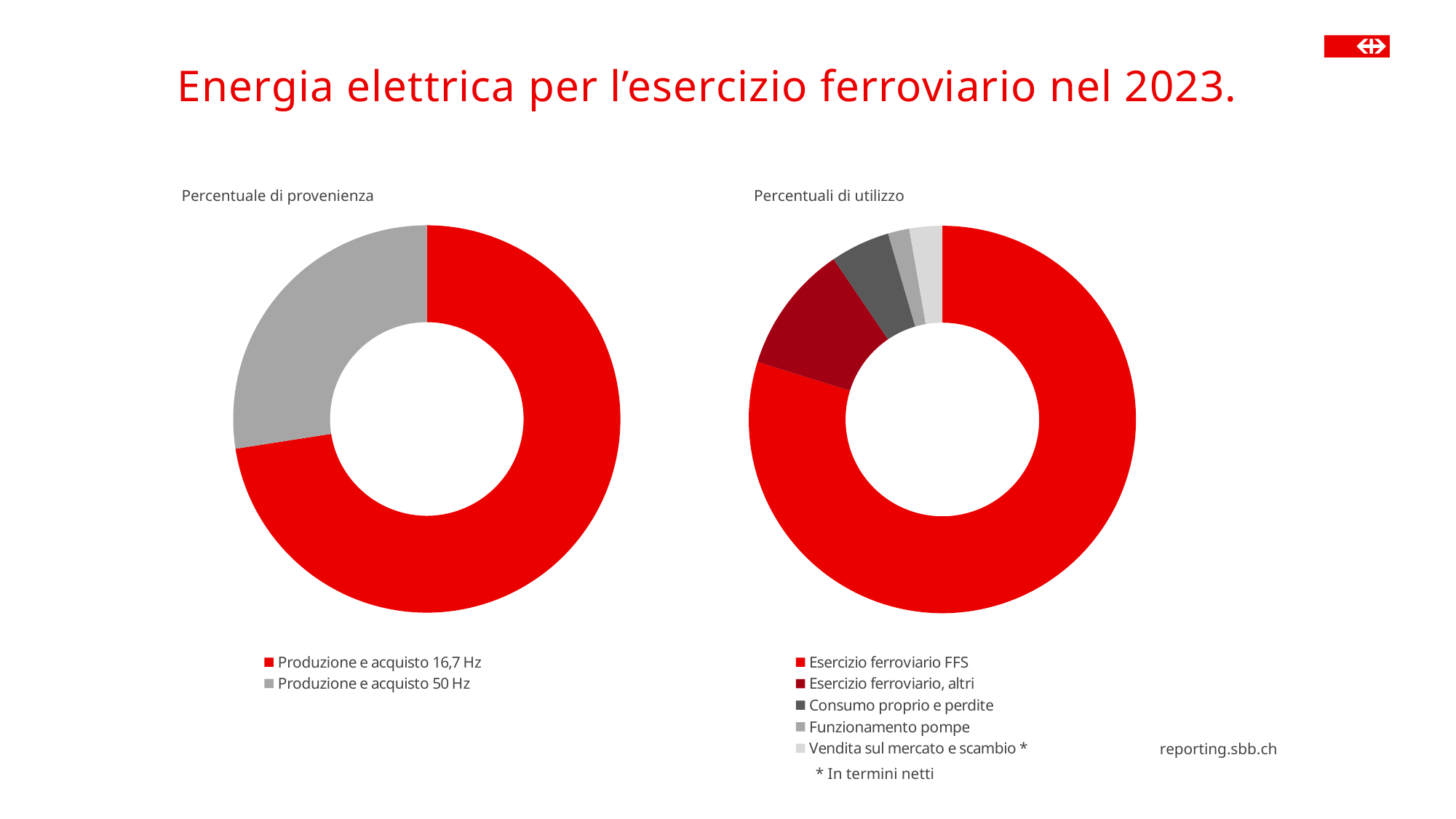
In the 'Percentuali di utilizzo' chart, which is larger: 'Esercizio ferroviario, altri' or 'Consumo proprio e perdite'? Esercizio ferroviario, altri How many entries does the legend of the 'Percentuale di provenienza' chart list? 2 What is the title of the slide? Energia elettrica per l'esercizio ferroviario nel 2023. In the 'Percentuale di provenienza' chart, what colour is the slice for 'Produzione e acquisto 50 Hz'? Grey In the 'Percentuali di utilizzo' chart, which category has the largest share? Esercizio ferroviario FFS In the 'Percentuale di provenienza' chart, how many slices are there? 2 What kind of chart is the 'Percentuali di utilizzo' chart? Pie chart (donut) In the 'Percentuali di utilizzo' chart, how many slices are there? 5 In the 'Percentuale di provenienza' chart, which category has the smallest share? Produzione e acquisto 50 Hz What kind of chart is the 'Percentuale di provenienza' chart? Pie chart (donut) In the 'Percentuale di provenienza' chart, which category has the largest share? Produzione e acquisto 16,7 Hz How many entries does the legend of the 'Percentuali di utilizzo' chart list? 5